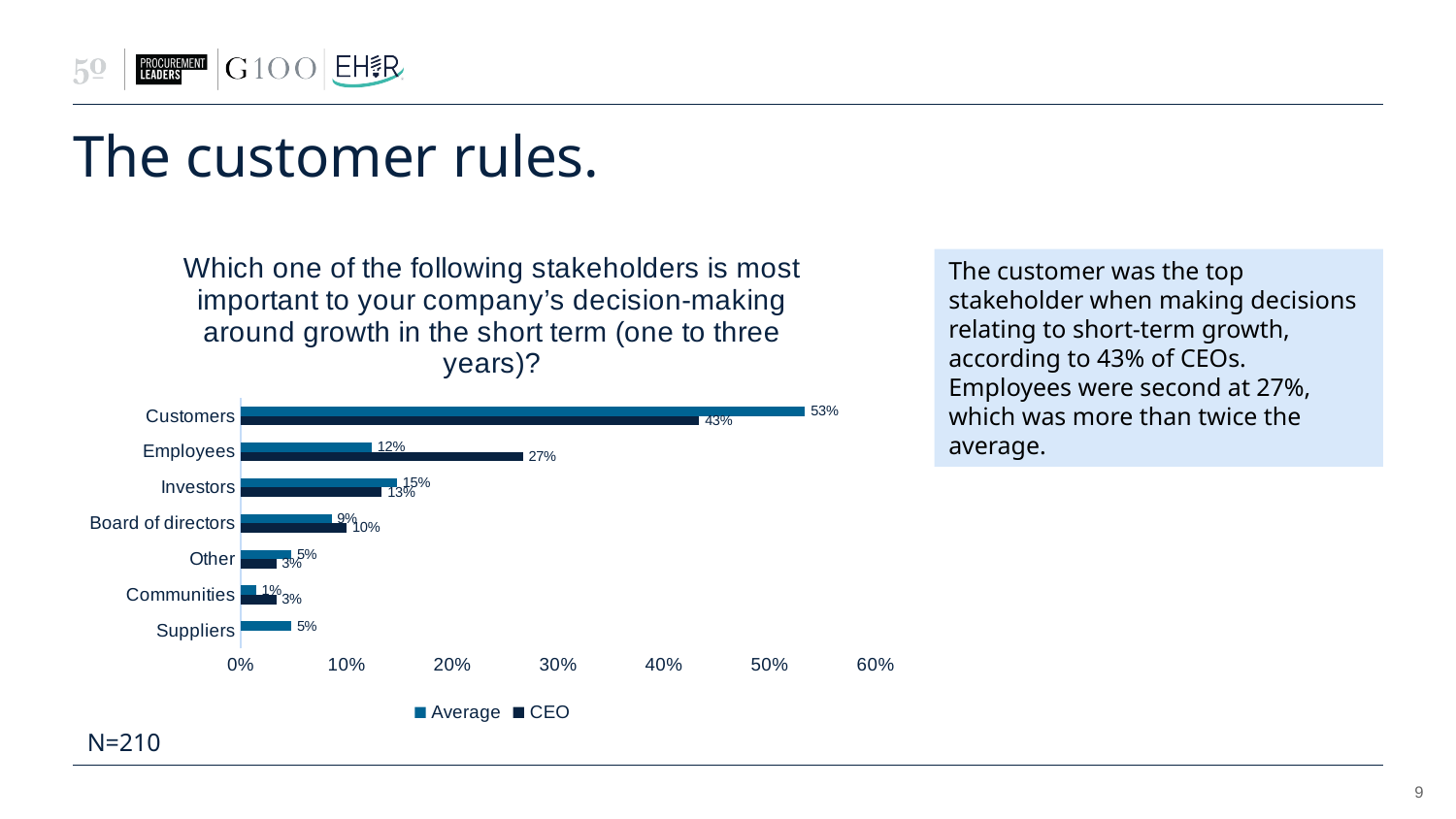
What is the Average value for Customers? 53% Which series is shown in the dark navy colour? CEO What is the CEO value for Customers? 43% What is the Average value for Investors? 15% What kind of chart is shown on the slide? Bar chart What is the difference between the CEO and Average values for Employees? 15% What is the CEO value for Employees? 27% For Investors, which is larger: the Average value or the CEO value? Average How many series does the legend list? 2 Which stakeholder has the highest CEO value? Customers Which stakeholder has the lowest Average value? Communities How many stakeholder categories are shown on the chart? 7